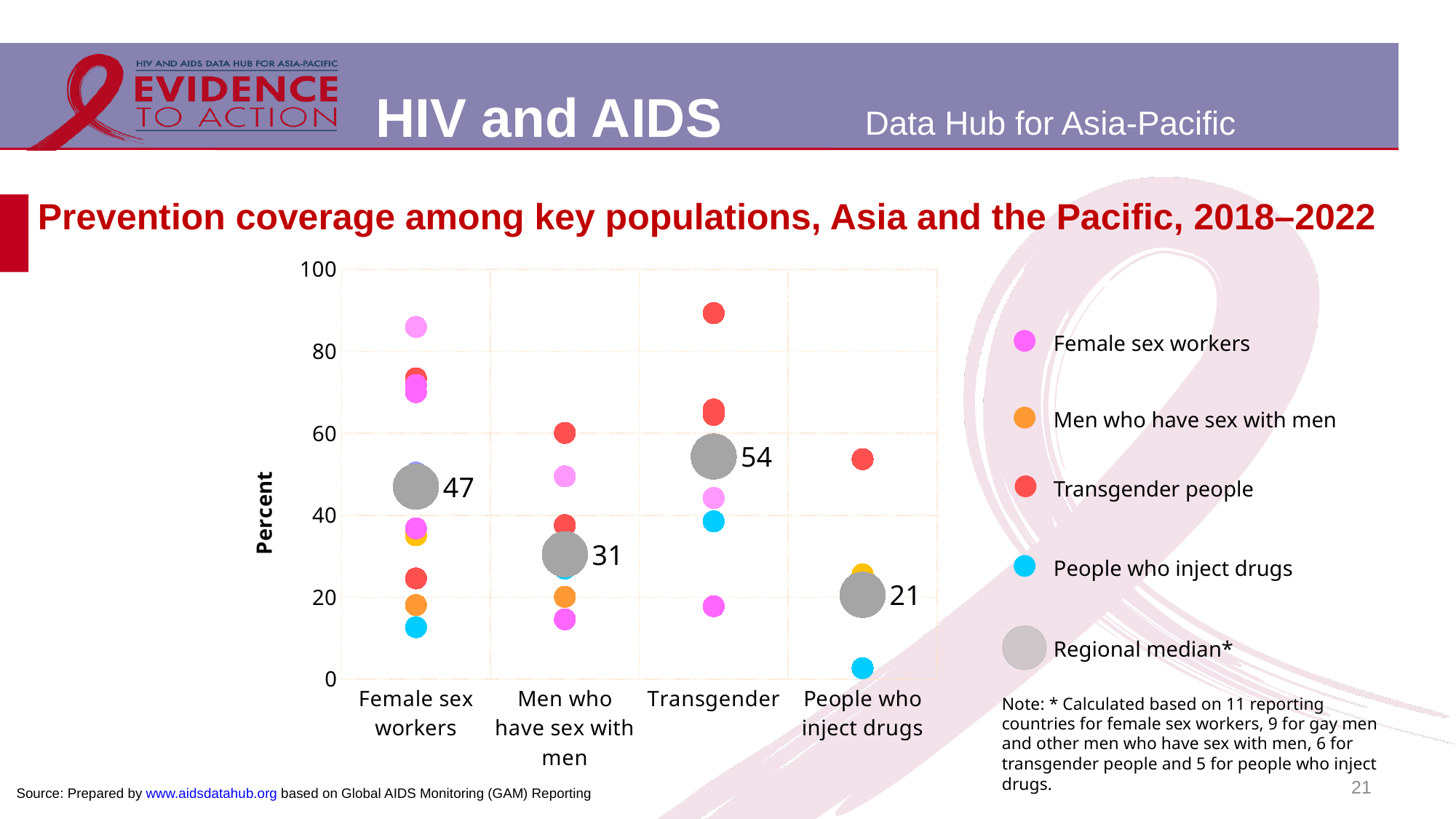
What is the label of the y axis? Percent Is the regional median for female sex workers larger or the regional median for men who have sex with men? Female sex workers What is the regional median prevention coverage for people who inject drugs? 21 What is the regional median prevention coverage for female sex workers? 47 What is the regional median prevention coverage for transgender people? 54 Which key population has the highest regional median prevention coverage? Transgender Which key population has the lowest regional median prevention coverage? People who inject drugs What is the difference between the regional median for transgender people and the regional median for people who inject drugs? 33 Is the highest transgender people data point greater or less than 80? greater How many entries does the legend list? 5 What is the regional median prevention coverage for men who have sex with men? 31 How many key population categories are shown on the x axis? 4